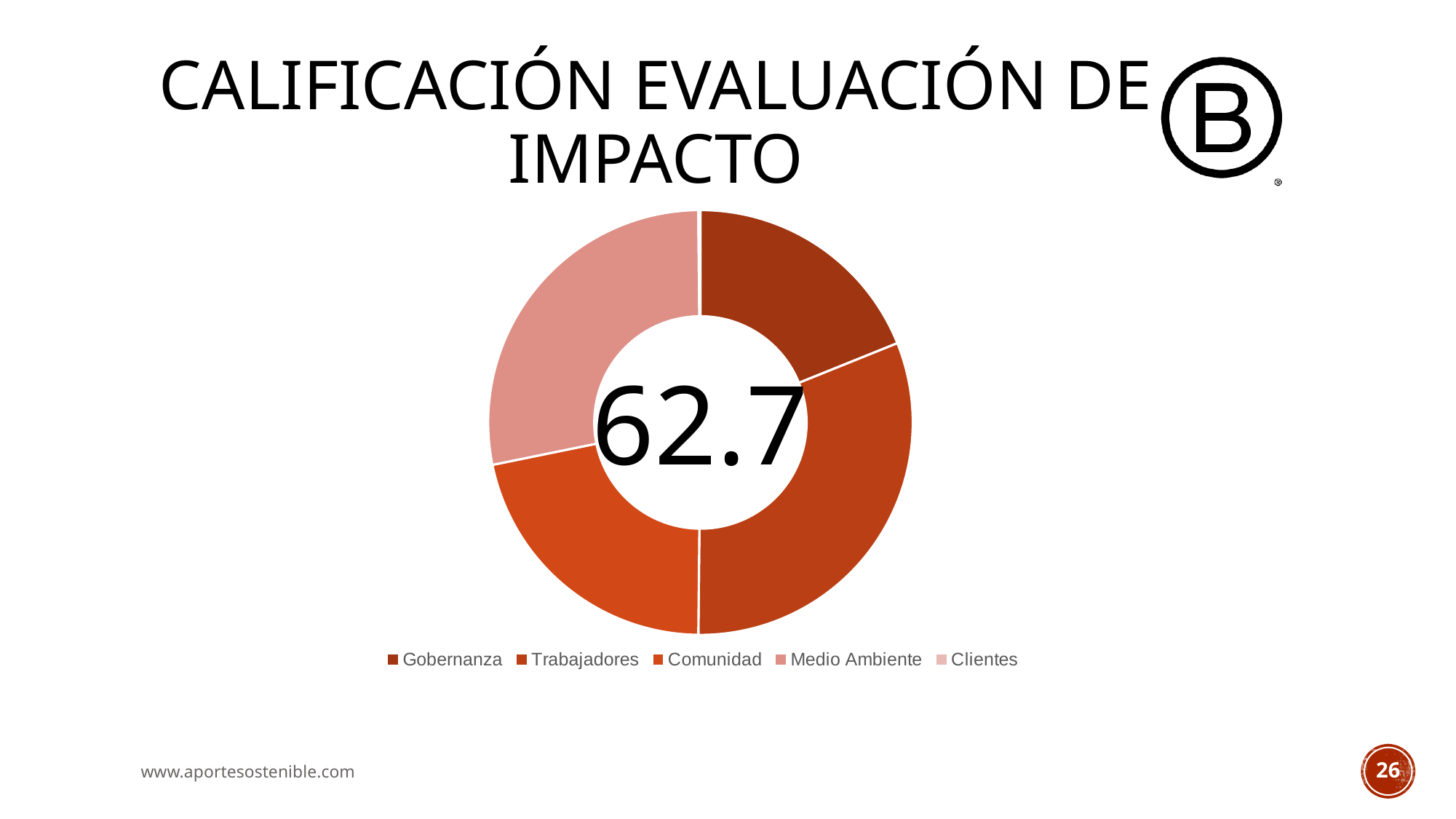
Which category has the largest slice in the chart? Trabajadores Which slice is larger, Trabajadores or Gobernanza? Trabajadores What number is displayed in the centre of the doughnut chart? 62.7 Which legend entry is listed first in the chart legend? Gobernanza Which slice is larger, Trabajadores or Medio Ambiente? Trabajadores Which slice is larger, Medio Ambiente or Gobernanza? Medio Ambiente What kind of chart is shown on the slide? doughnut chart What is the title of the slide containing the chart? CALIFICACIÓN EVALUACIÓN DE IMPACTO Which legend entry is listed last in the chart legend? Clientes How many categories does the legend of the chart list? 5